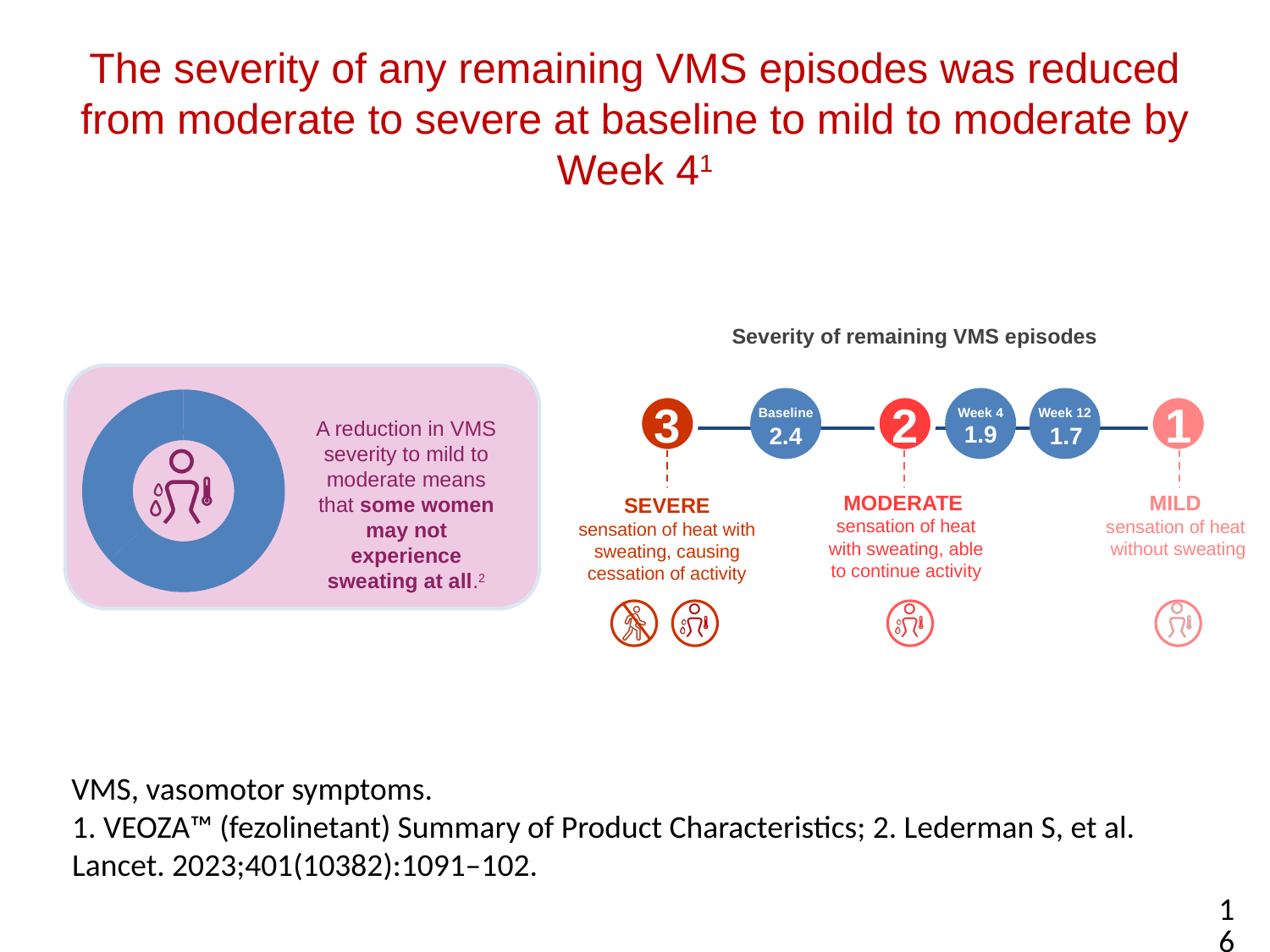
In the 'Severity of remaining VMS episodes' diagram, do the severity values rise or fall from Baseline to Week 12? fall In the 'Severity of remaining VMS episodes' diagram, is the Week 4 severity value greater or less than 2? less In the 'Severity of remaining VMS episodes' diagram, what is the difference between the Baseline and Week 12 severity values? 0.7 In the 'Severity of remaining VMS episodes' diagram, which is larger, the severity value at Week 4 or at Week 12? Week 4 In the 'Severity of remaining VMS episodes' diagram, which time point has the highest severity value? Baseline In the 'Severity of remaining VMS episodes' diagram, which time point has the lowest severity value? Week 12 In the 'Severity of remaining VMS episodes' diagram, what is the difference between the Baseline and Week 4 severity values? 0.5 In the 'Severity of remaining VMS episodes' diagram, what is the severity value at Week 12? 1.7 How many time points with severity values are shown in the 'Severity of remaining VMS episodes' diagram? 3 In the 'Severity of remaining VMS episodes' diagram, what severity label corresponds to the scale value 3? SEVERE In the 'Severity of remaining VMS episodes' diagram, what is the severity value at Week 4? 1.9 In the 'Severity of remaining VMS episodes' diagram, what is the severity value at Baseline? 2.4